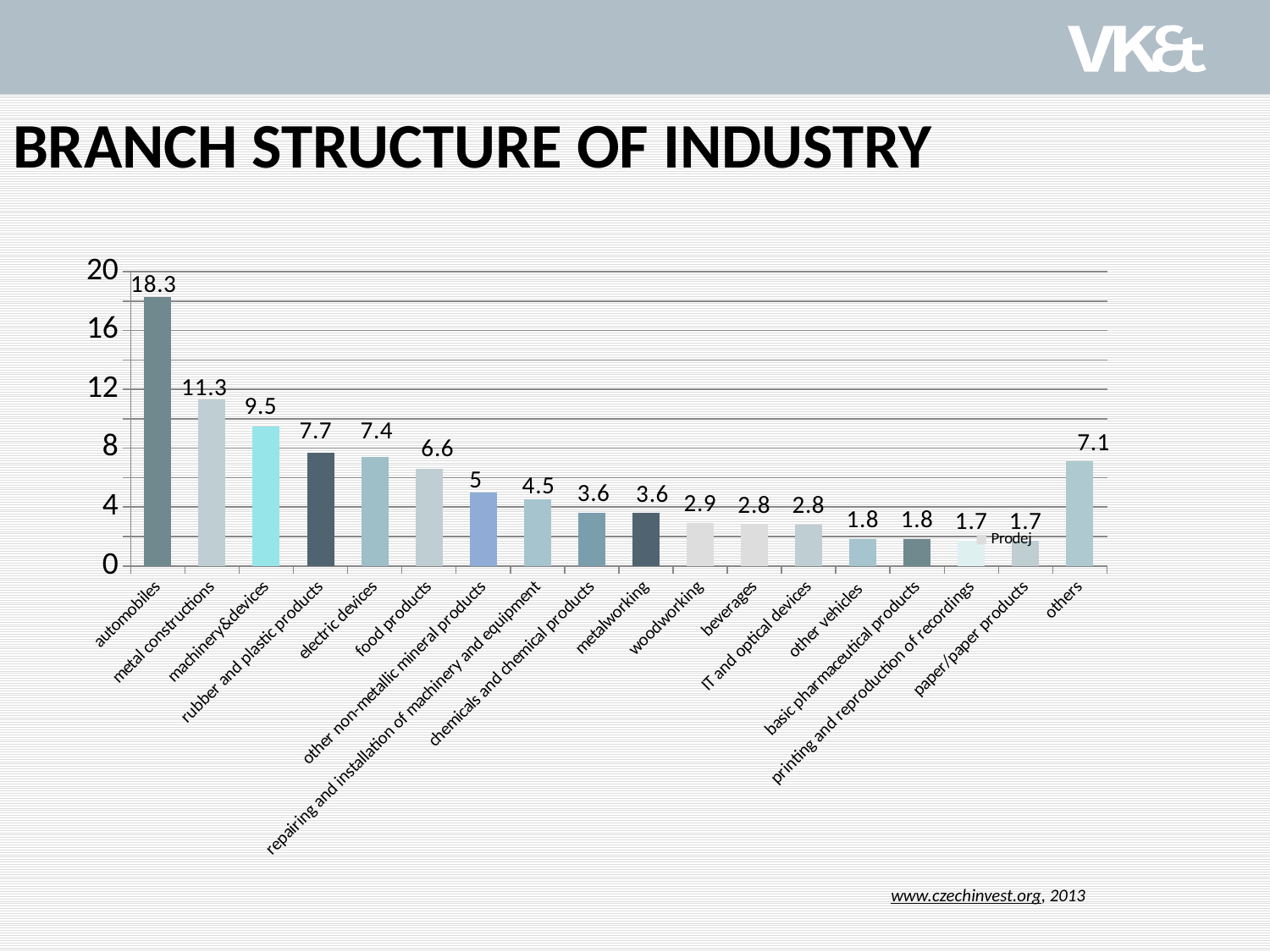
What is the value for others? 7.1 Which category has the highest value? automobiles What is the difference between the values for automobiles and metal constructions? 7 What is the value for metal constructions? 11.3 What is the title of the slide? BRANCH STRUCTURE OF INDUSTRY How many categories are shown on the x axis? 18 What is the difference between the values for machinery&devices and rubber and plastic products? 1.8 What is the value for food products? 6.6 Which is larger, the value for electric devices or the value for others? electric devices Which is larger, the value for woodworking or the value for other vehicles? woodworking What kind of chart is shown on the slide? bar chart What is the value for automobiles? 18.3